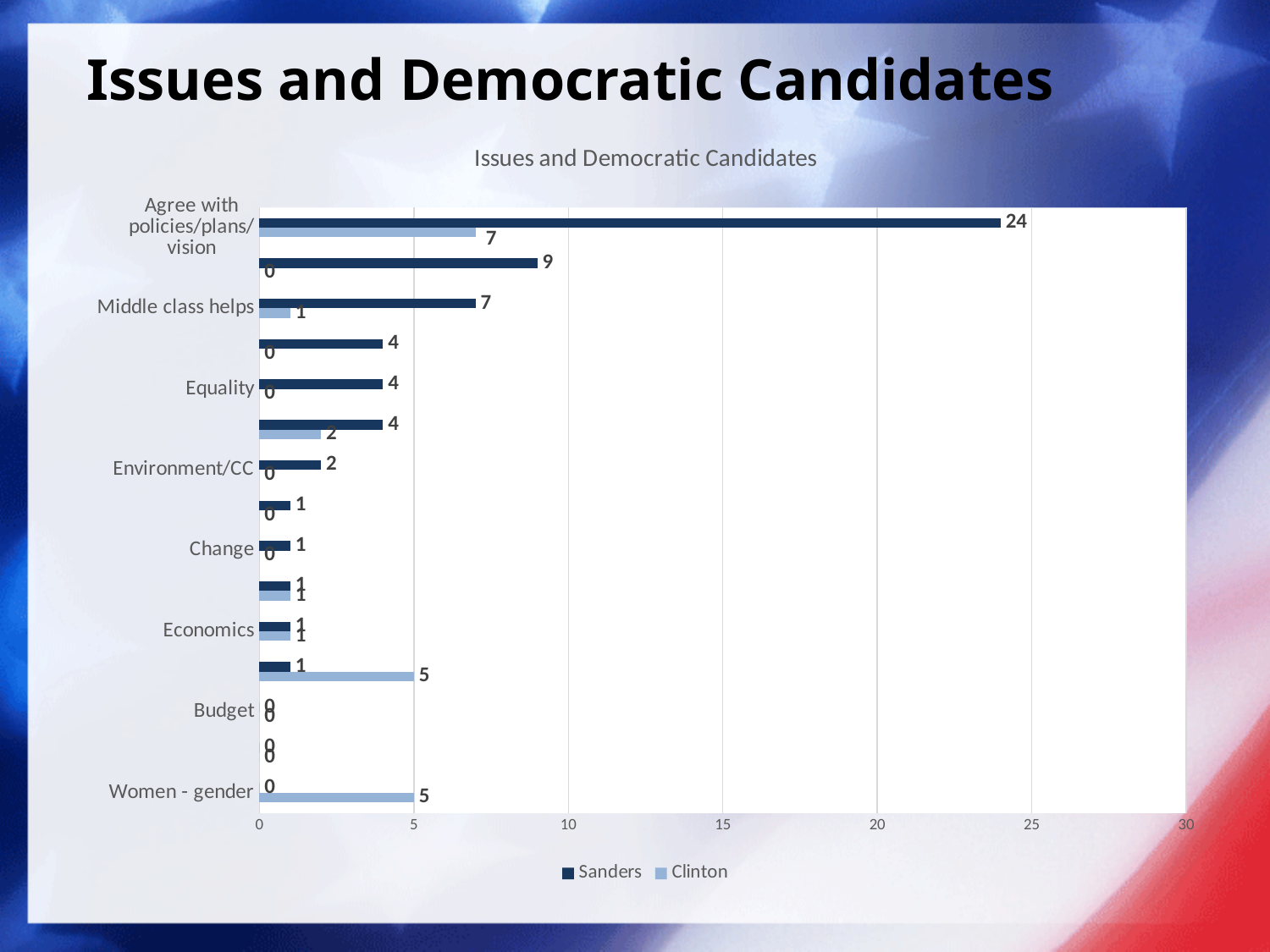
What is the difference between the Sanders and Clinton values for "Agree with policies/plans/vision"? 17 Which series is shown in the darker blue colour? Sanders For "Women - gender", which series has the larger value, Sanders or Clinton? Clinton What kind of chart is shown on the slide? Bar chart What is the Sanders value for "Middle class helps"? 7 How many series does the legend list? 2 Which labeled category has the highest Sanders value? Agree with policies/plans/vision What is the Clinton value for "Women - gender"? 5 What is the Sanders value for "Equality"? 4 What is the Clinton value for "Agree with policies/plans/vision"? 7 Is the Sanders value for "Agree with policies/plans/vision" greater or less than 20? greater What is the Sanders value for "Agree with policies/plans/vision"? 24